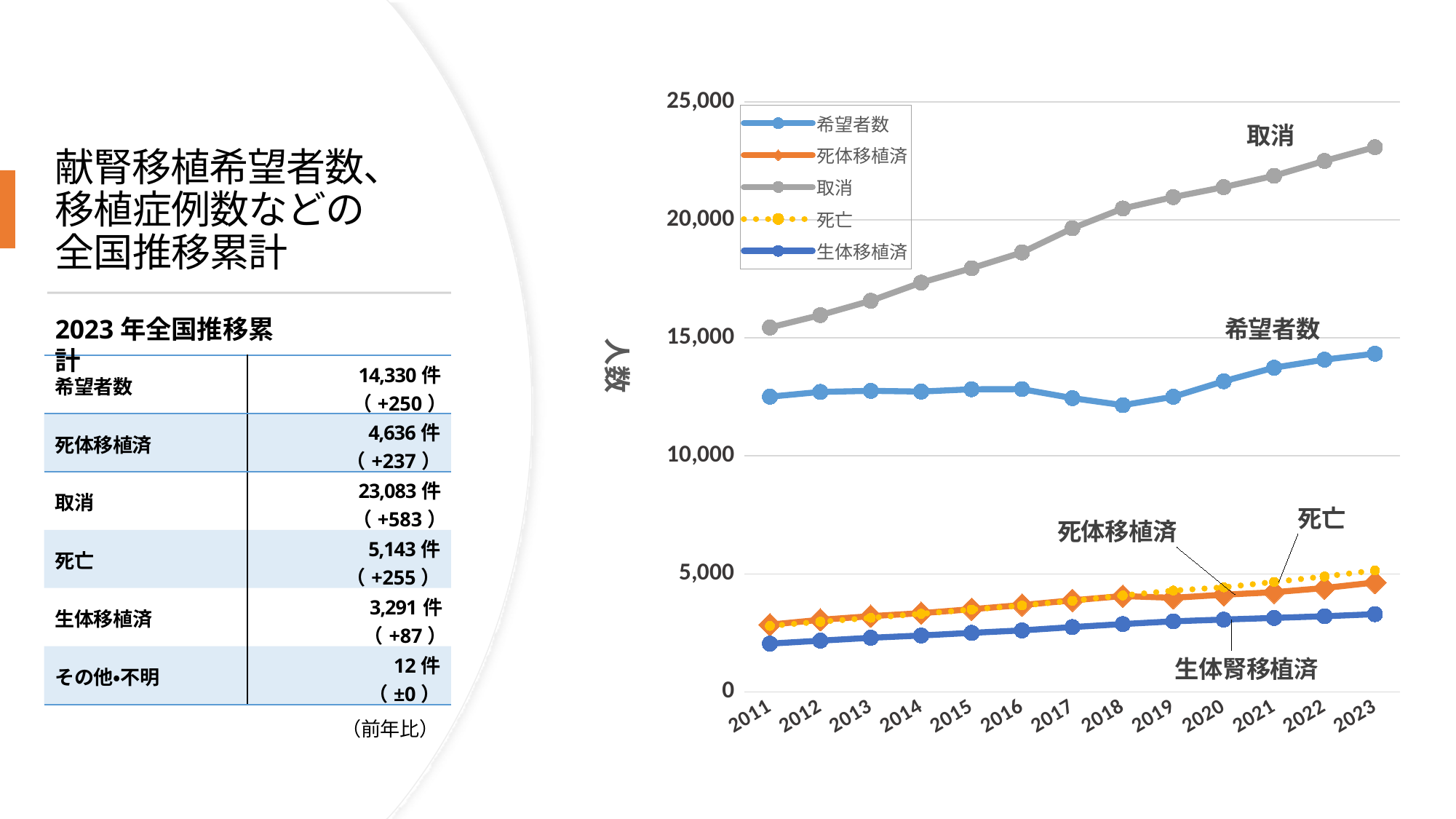
Which series has the lowest value in 2023? 生体移植済 What kind of chart is shown on the slide? line chart Is the value for 取消 in 2023 greater or less than 20,000? greater What is the label on the vertical axis of the chart? 人数 Is the value for 生体移植済 in 2011 greater or less than 5,000? less Does the 取消 series rise or fall from 2011 to 2023? rise Which series has the highest value in 2023? 取消 How many years are shown along the x axis of the chart? 13 In 2023, which is larger: 取消 or 希望者数? 取消 Is the value for 希望者数 in 2018 greater or less than 15,000? less According to the table on the slide, what is the 2023 value for 希望者数? 14,330 件 How many series does the chart legend list? 5